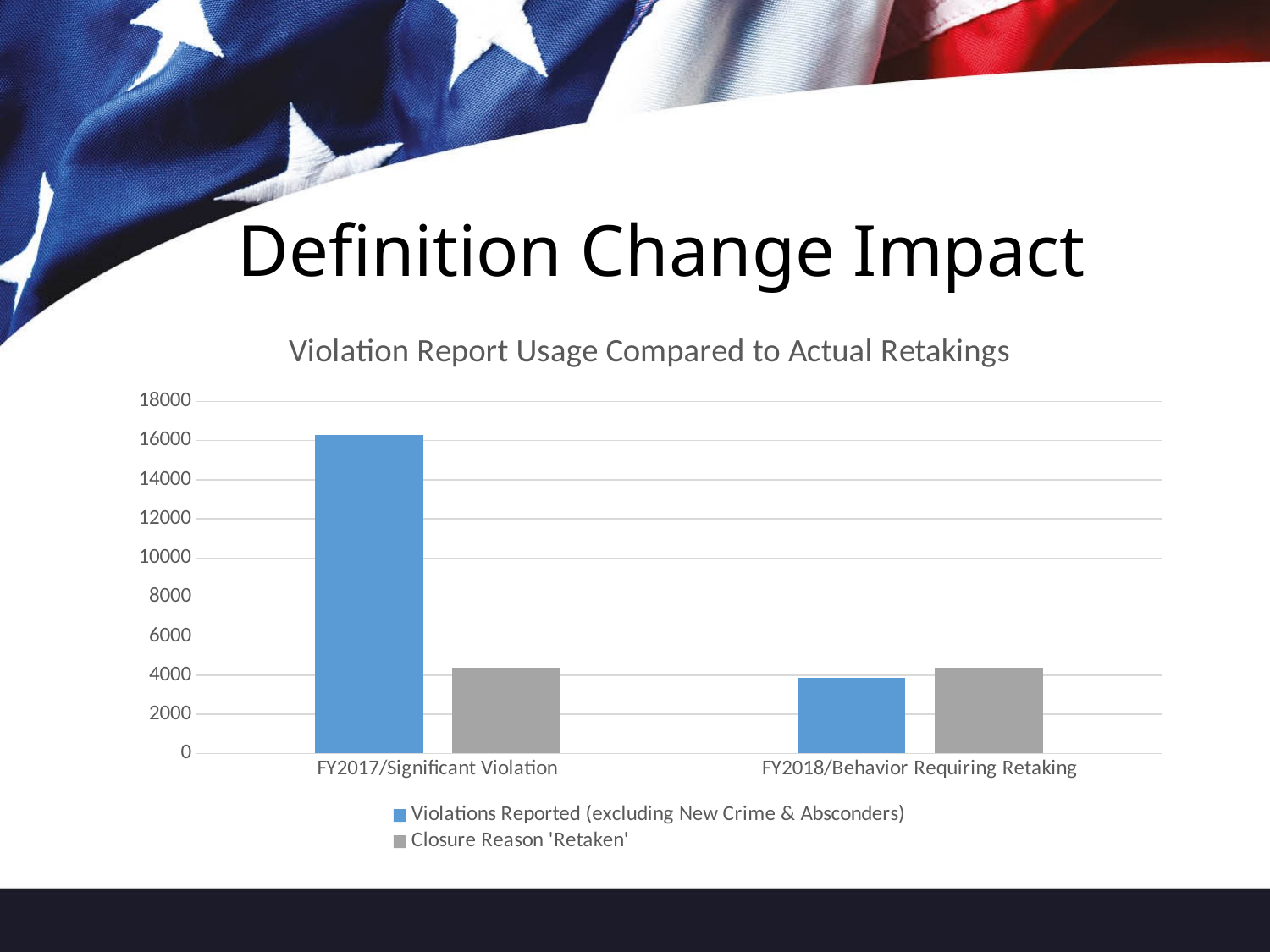
Is the value for Violations Reported (excluding New Crime & Absconders) in FY2018/Behavior Requiring Retaking greater or less than 6000? less How many categories are shown on the x axis? 2 In FY2017/Significant Violation, which is larger: Violations Reported (excluding New Crime & Absconders) or Closure Reason 'Retaken'? Violations Reported (excluding New Crime & Absconders) Which category has the highest bar in the chart? FY2017/Significant Violation How many series does the legend list? 2 Is the value for Violations Reported (excluding New Crime & Absconders) in FY2017/Significant Violation greater or less than 14000? greater What is the title of the chart? Violation Report Usage Compared to Actual Retakings What kind of chart is shown on the slide? bar chart Is the value for Closure Reason 'Retaken' in FY2017/Significant Violation greater or less than 6000? less Does the value for Violations Reported (excluding New Crime & Absconders) rise or fall from FY2017/Significant Violation to FY2018/Behavior Requiring Retaking? fall Which series is shown in blue? Violations Reported (excluding New Crime & Absconders)